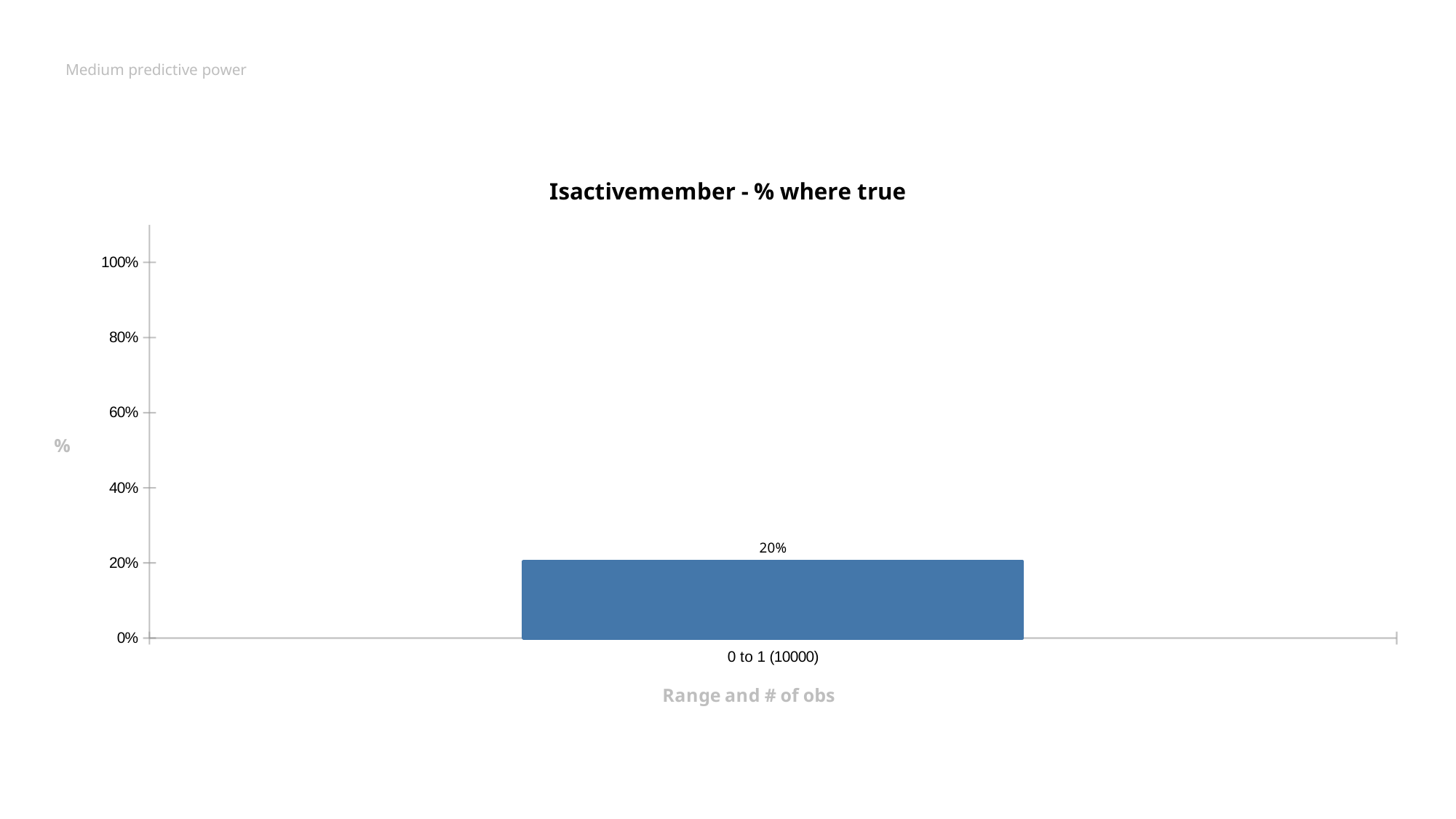
What kind of chart is shown on the slide? bar chart What is the label of the x axis? Range and # of obs What is the highest value shown on the y axis? 100% How many bars are plotted in the chart? 1 What is the value for the category "0 to 1 (10000)"? 20% What is the title of the chart? Isactivemember - % where true Is the value for "0 to 1 (10000)" greater or less than 40%? less What is the label of the only category on the x axis? 0 to 1 (10000)